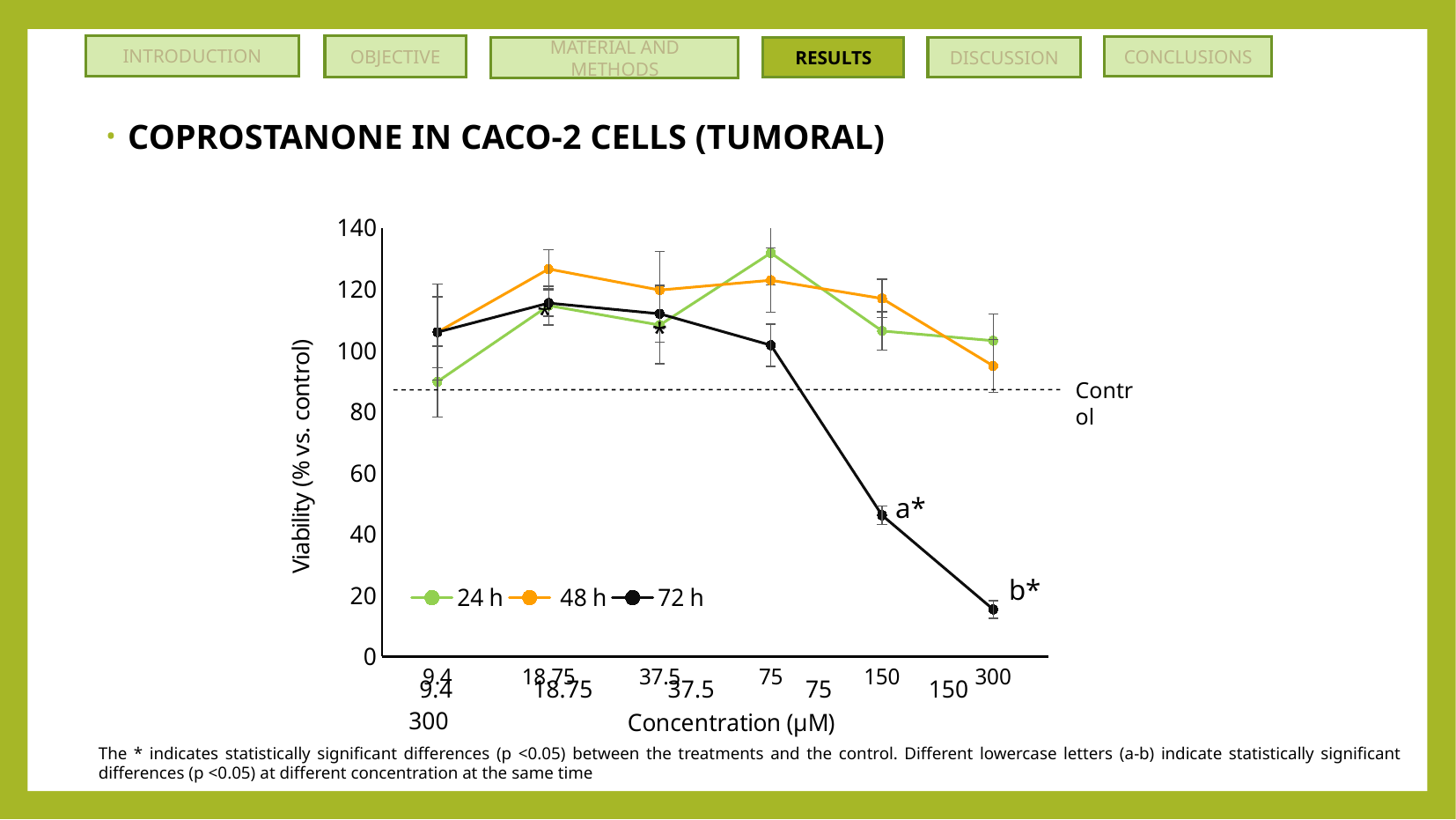
Is the 72 h viability at 150 µM greater or less than 60? less How many concentration values are shown on the x axis? 6 How many series does the legend list? 3 At which concentration is the 72 h viability lowest? 300 Does the 72 h viability rise or fall from 75 µM to 300 µM? fall What is the label of the horizontal dashed line on the chart? Control What kind of chart is shown on the slide? line chart At 150 µM, which series has the higher viability, 48 h or 72 h? 48 h Is the 72 h viability at 300 µM greater or less than 40? less At 300 µM, which series has the higher viability, 24 h or 72 h? 24 h Is the 48 h viability at 18.75 µM greater or less than 100? greater At which concentration is the 24 h viability highest? 75